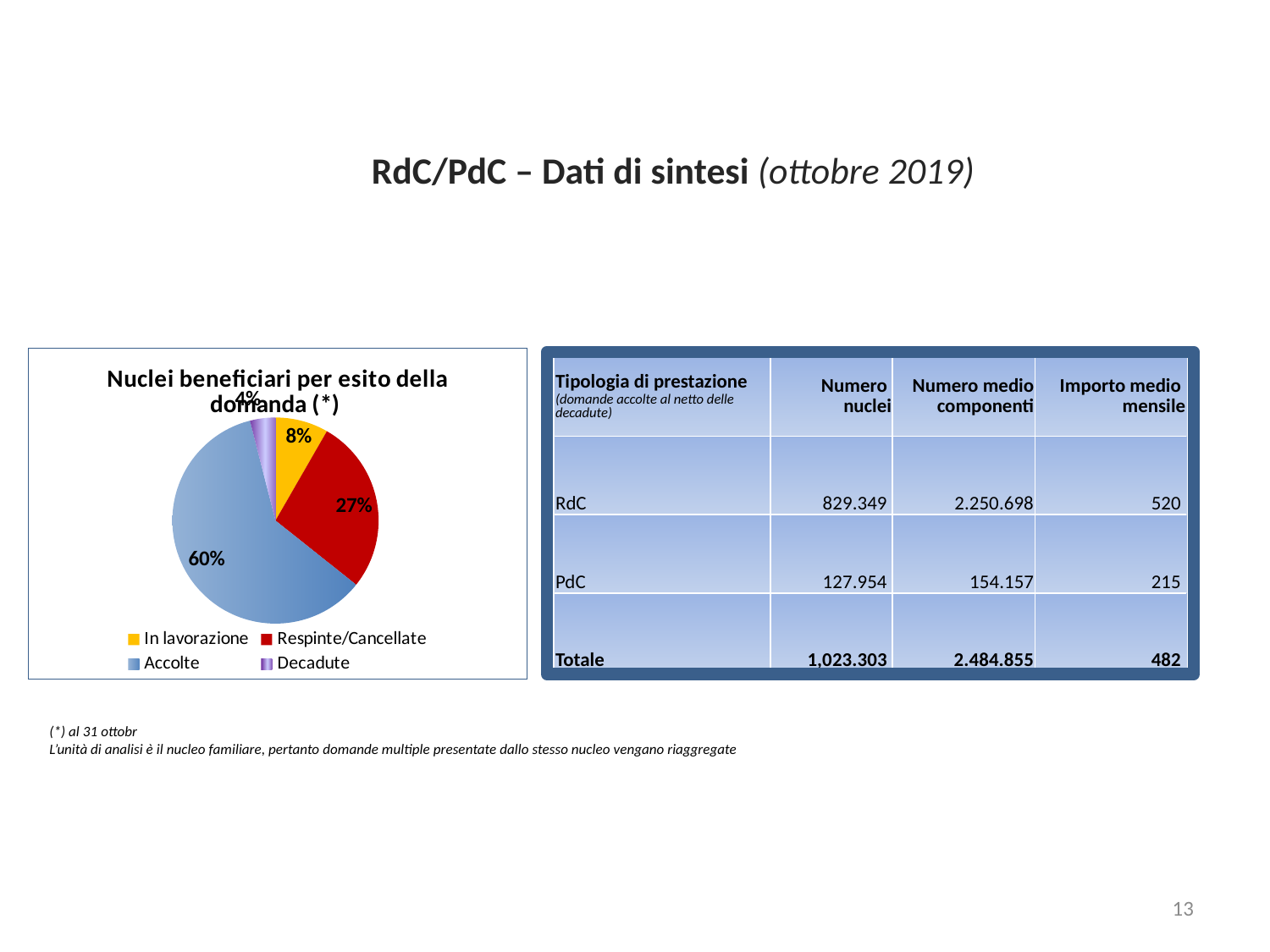
What colour is the Respinte/Cancellate slice in the pie chart? Red What is the difference in percentage points between the Accolte and Respinte/Cancellate slices? 33 What share of the pie does the Respinte/Cancellate slice represent? 27% What share of the pie does the In lavorazione slice represent? 8% What share of the pie does the Decadute slice represent? 4% Which category has the smallest slice of the pie? Decadute Which slice is larger, In lavorazione or Respinte/Cancellate? Respinte/Cancellate Which category has the largest slice of the pie? Accolte What kind of chart is shown on the slide? Pie chart What is the title of the pie chart? Nuclei beneficiari per esito della domanda (*) How many categories does the pie chart show? 4